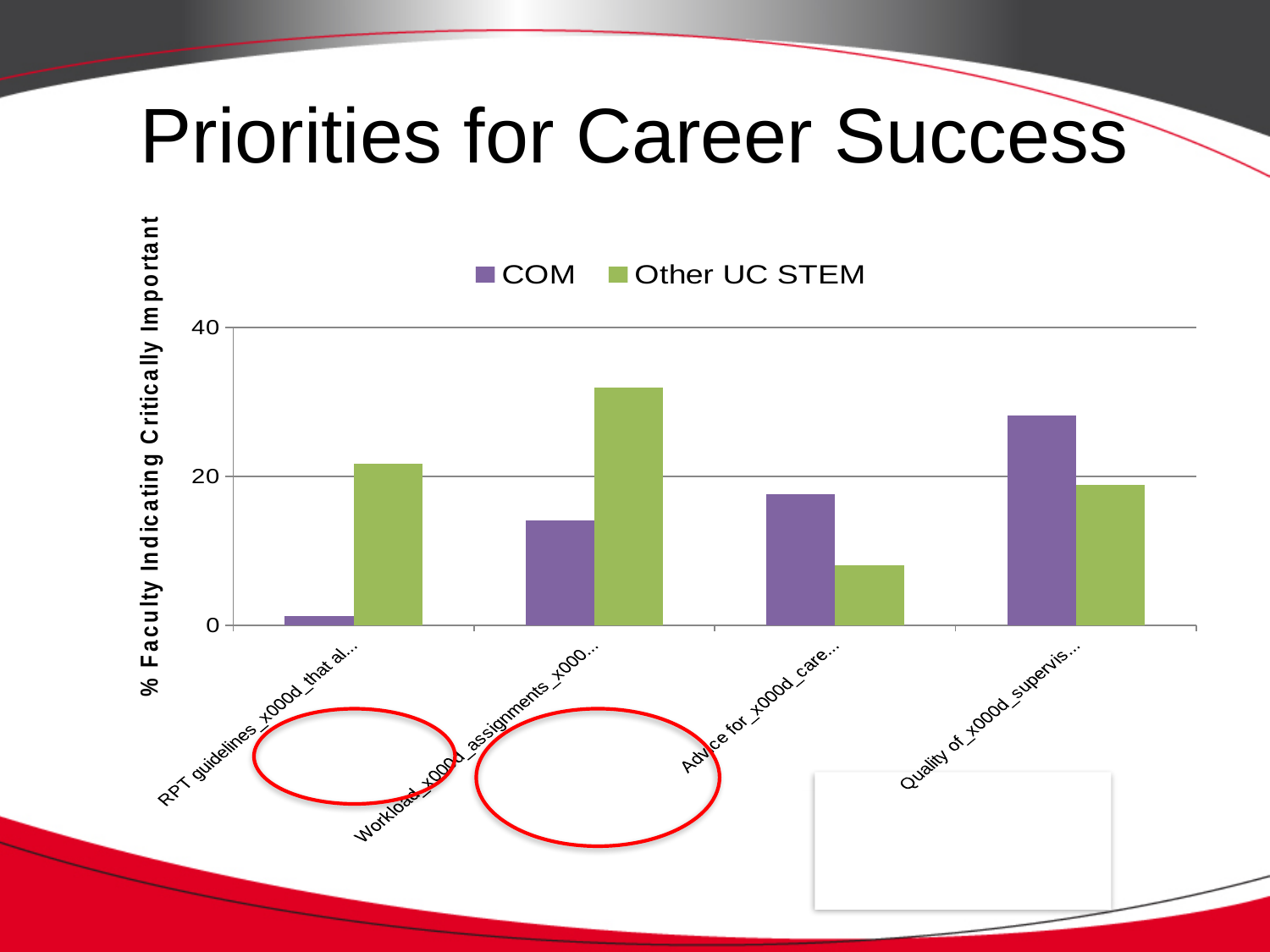
What kind of chart is shown on the slide? bar chart What is the title of the vertical axis? % Faculty Indicating Critically Important Is the Other UC STEM value for the Workload category greater or less than 20? greater Which category has the lowest COM value? RPT guidelines Which category has the highest Other UC STEM value? Workload assignments Is the Other UC STEM value for the Advice for career category greater or less than 20? less How many categories are plotted along the x axis? 4 For the Workload category, which series has the larger value, COM or Other UC STEM? Other UC STEM What are the two series named in the legend? COM and Other UC STEM Is the COM value for the Quality of supervision category greater or less than 20? greater How many series does the legend list? 2